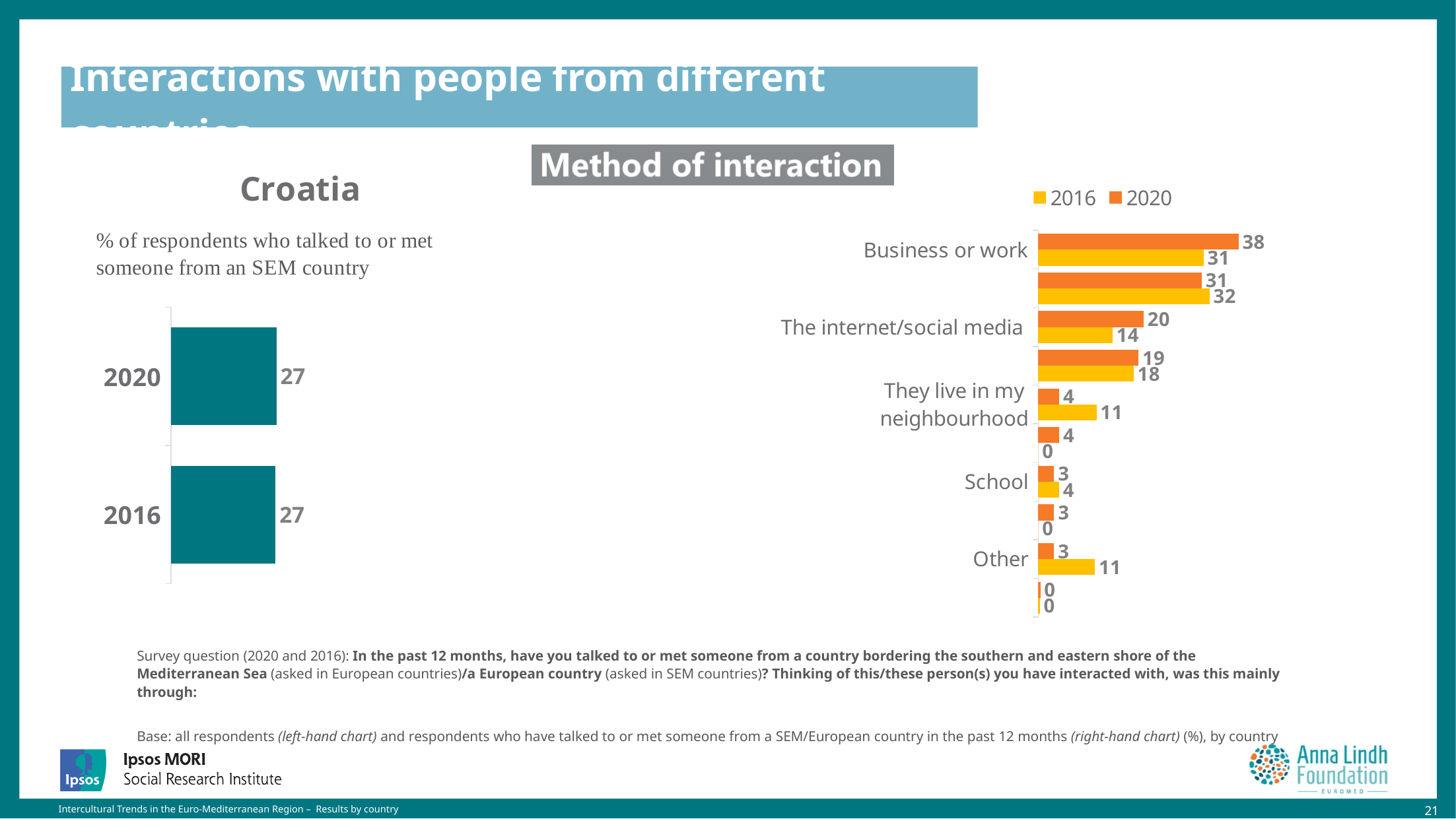
In the Method of interaction chart, what is the 2016 value for Business or work? 31 In the Method of interaction chart, which labelled method has the highest 2020 value? Business or work What kind of chart is the left-hand Croatia chart? Bar chart In the left-hand Croatia chart, what is the difference between the 2020 and 2016 values? 0 In the Method of interaction chart, which is larger for Other: the 2016 value or the 2020 value? 2016 In the left-hand Croatia chart, what is the value for 2016? 27 In the Method of interaction chart, what is the difference between the 2020 and 2016 values for The internet/social media? 6 In the Method of interaction chart, what is the 2020 value for Business or work? 38 How many series does the legend of the Method of interaction chart list? 2 In the Method of interaction chart, what is the 2016 value for They live in my neighbourhood? 11 In the left-hand Croatia chart, what percentage of respondents talked to or met someone from an SEM country in 2020? 27 In the Method of interaction chart, what is the 2020 value for The internet/social media? 20